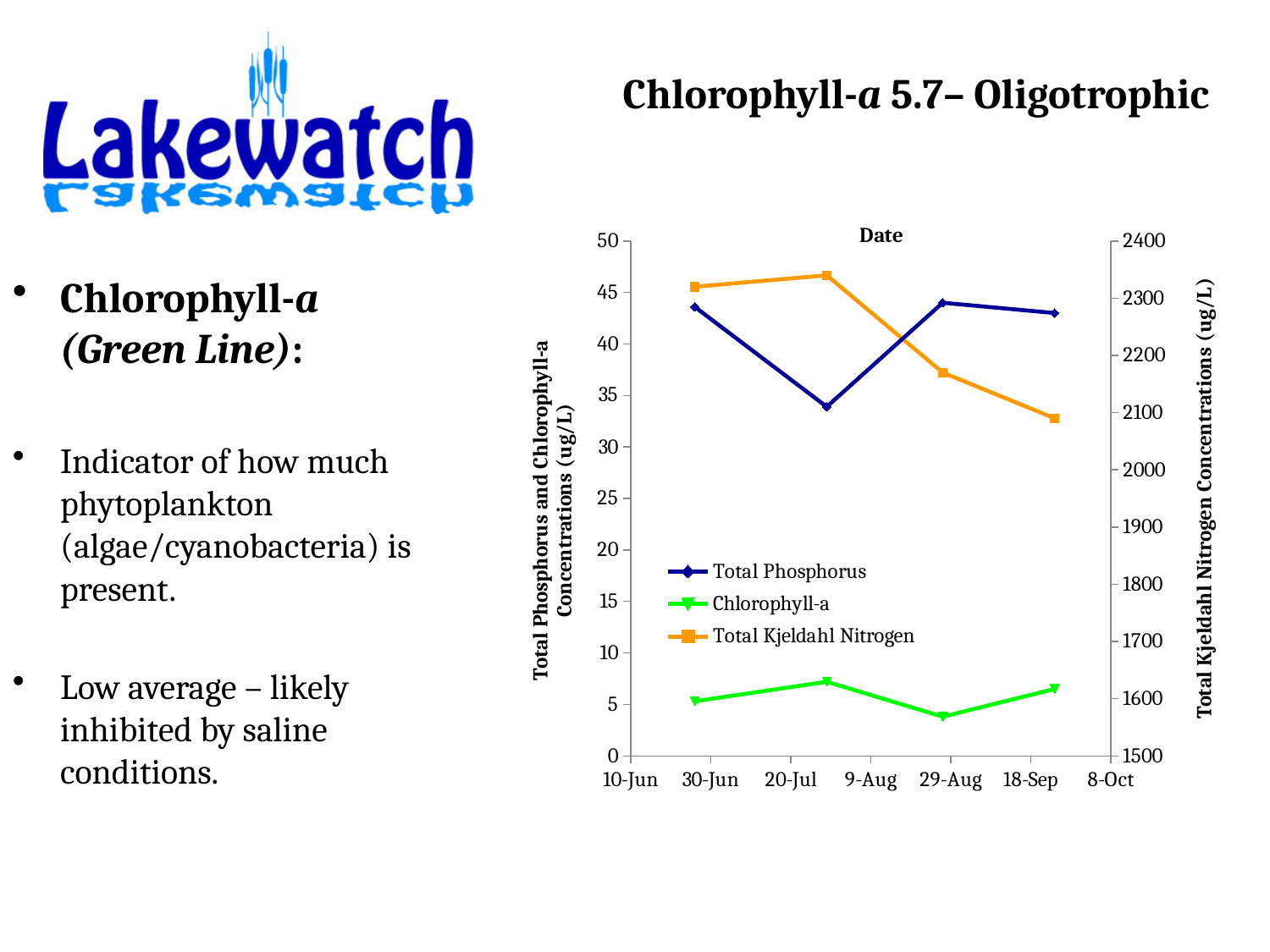
What is the label of the right-hand vertical axis of the chart? Total Kjeldahl Nitrogen Concentrations (ug/L) Which series plotted on the left axis has the higher values, Total Phosphorus or Chlorophyll-a? Total Phosphorus Is the second plotted value of Total Phosphorus (late July) greater or less than 40 on the left axis? less Does the Total Kjeldahl Nitrogen line rise or fall overall from its first point to its last point? fall What kind of chart is shown on the slide? line chart Is the first plotted value of Total Kjeldahl Nitrogen (late June) greater or less than 2200 on the right axis? greater How many series does the chart legend list? 3 How many data points are plotted for the Total Phosphorus series? 4 What colour is the Chlorophyll-a line in the chart? green Is the first plotted value of Total Phosphorus (late June) greater or less than 40 on the left axis? greater